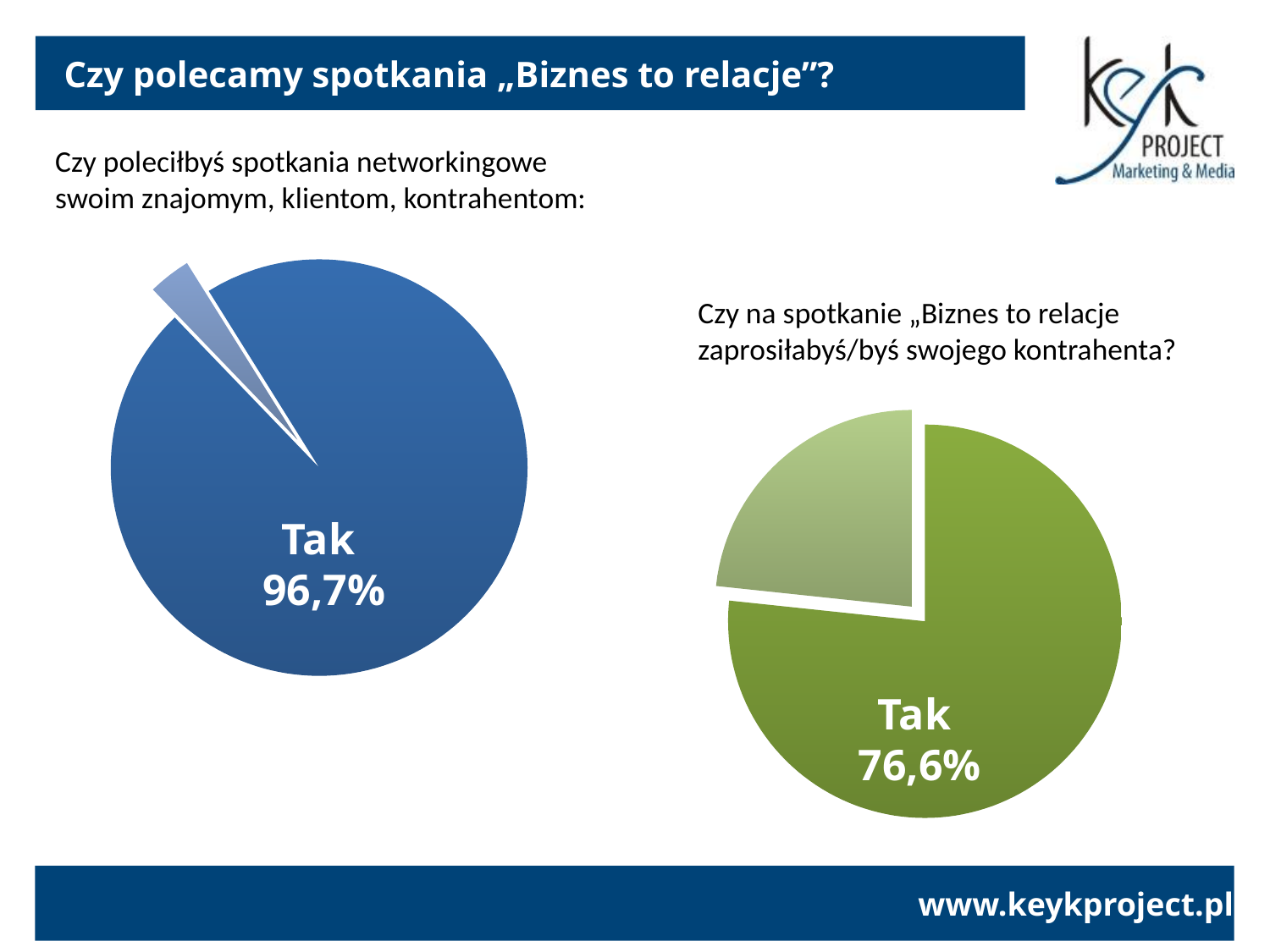
How many slices does the left pie chart have? 2 What type of chart is used on the right side of the slide? Pie chart In the right pie chart (Czy na spotkanie „Biznes to relacje” zaprosiłabyś/byś swojego kontrahenta?), what percentage is shown for "Tak"? 76,6% In the left pie chart (Czy poleciłbyś spotkania networkingowe...), what percentage is shown for "Tak"? 96,7% What share of the left pie chart does the "Tak" slice represent? 96,7% What colour is the "Tak" slice in the right pie chart? Green How many slices does the right pie chart have? 2 What is the difference between the "Tak" share in the left pie chart and the "Tak" share in the right pie chart? 20,1% What share of the right pie chart does the "Tak" slice represent? 76,6% Which chart shows a larger "Tak" share, the left pie chart or the right pie chart? The left pie chart In the right pie chart, is the "Tak" slice the larger or the smaller of the two slices? Larger What type of chart is used on the left side of the slide? Pie chart